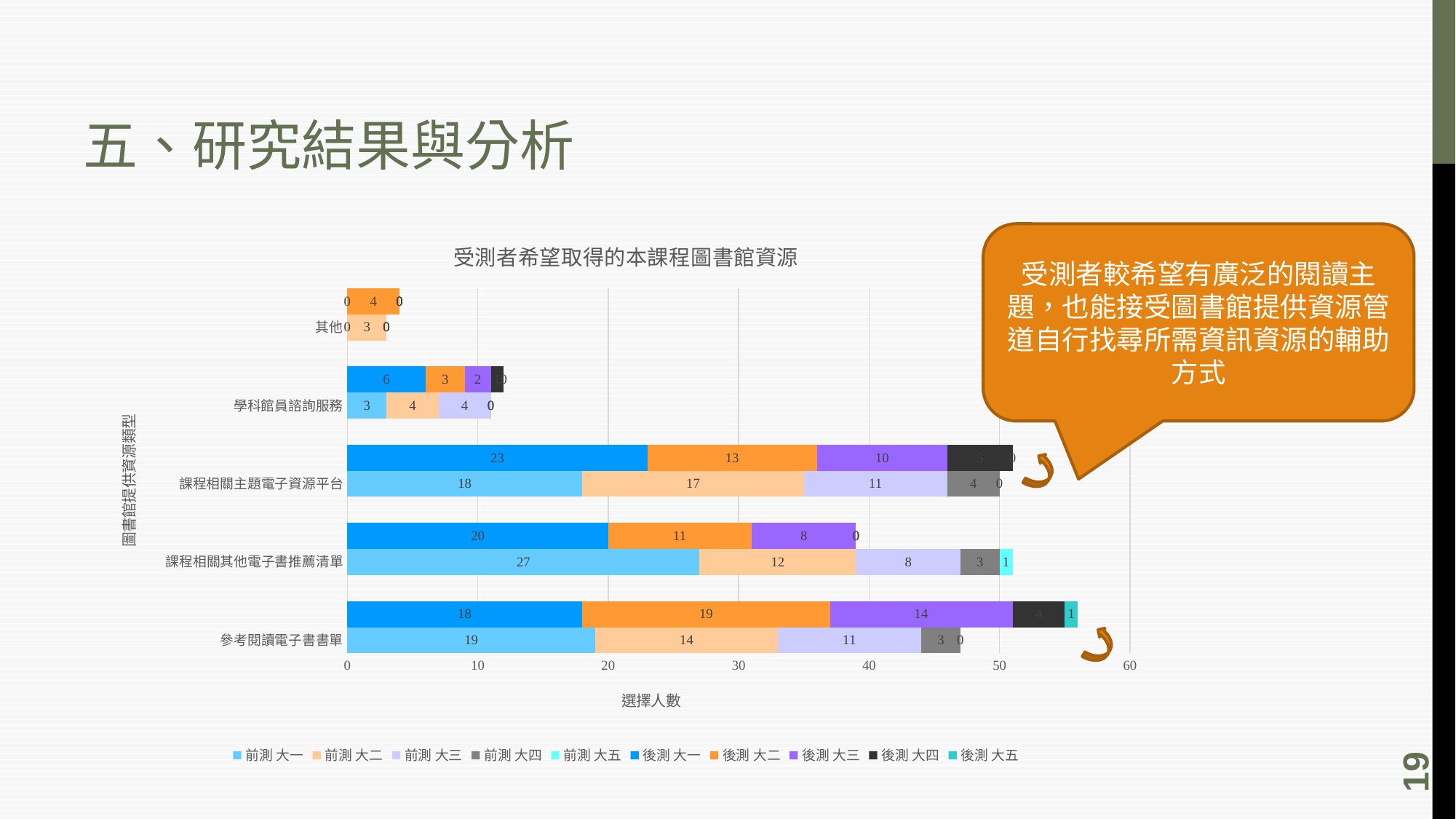
What is the 後測 大一 value for 課程相關主題電子資源平台? 23 For 課程相關其他電子書推薦清單, what is the difference between the 前測 大一 value and the 後測 大一 value? 7 Which category has the highest 前測 大一 value? 課程相關其他電子書推薦清單 What is the 前測 大二 value for 其他? 3 Which has the larger 後測 大一 value: 課程相關主題電子資源平台 or 參考閱讀電子書書單? 課程相關主題電子資源平台 What kind of chart is shown on the slide? Stacked bar chart How many resource categories are shown on the y axis of the chart? 5 What is the 前測 大一 value for 課程相關其他電子書推薦清單? 27 What is the total of the 前測 stacked bar for 課程相關其他電子書推薦清單? 51 What is the 後測 大二 value for 參考閱讀電子書書單? 19 What is the title of the x axis of the chart? 選擇人數 How many series does the legend of the chart list? 10